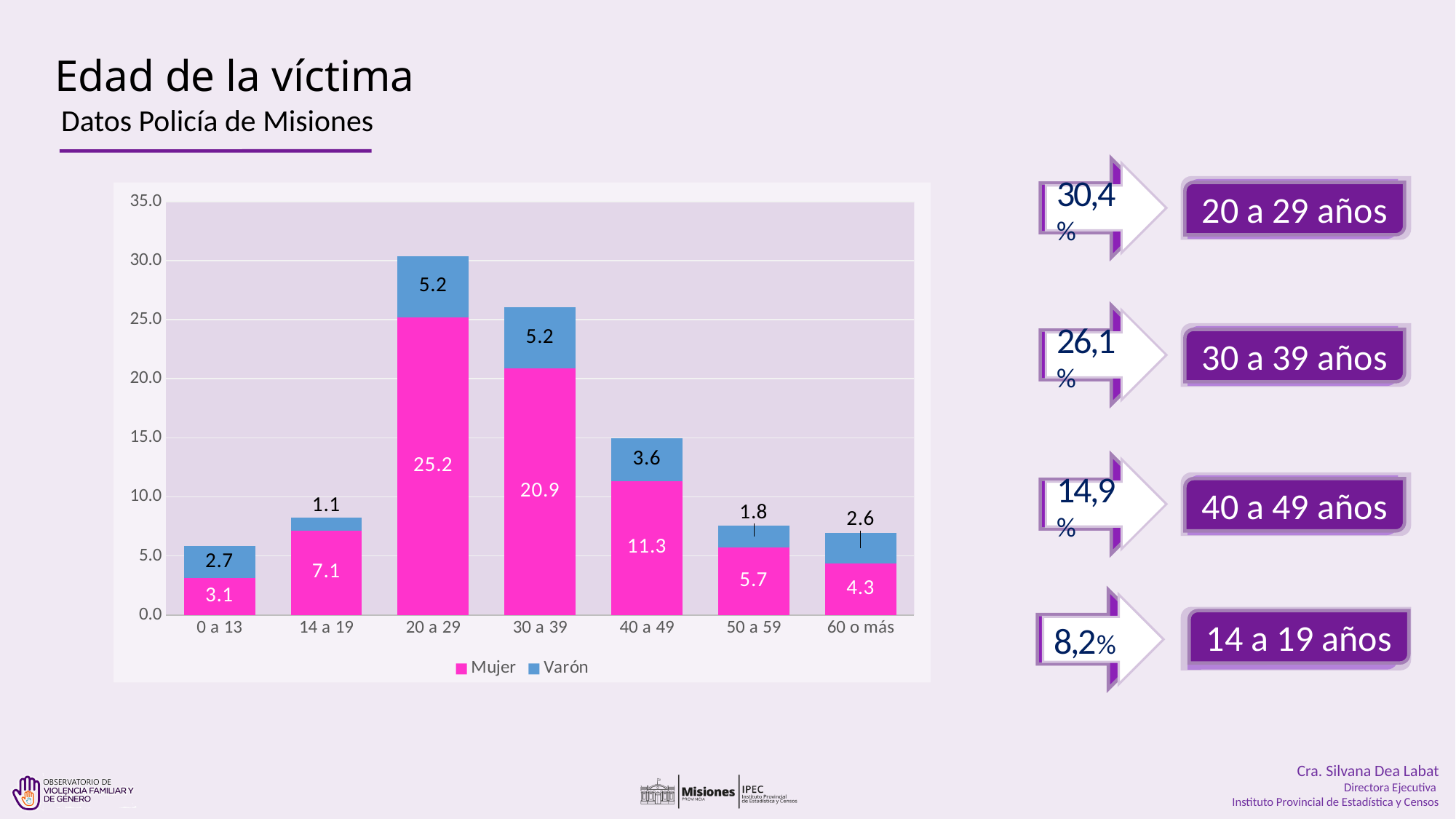
Which age group has the lowest Varón value? 14 a 19 Which is larger, the Varón value for 0 a 13 or the Varón value for 50 a 59? 0 a 13 How many series does the legend list? 2 How many age groups are shown on the x axis? 7 Which age group has the highest Mujer value? 20 a 29 What kind of chart is shown on the slide? Stacked bar chart What is the Varón value for the 40 a 49 age group? 3.6 What is the total stacked value for the 40 a 49 bar? 14.9 What is the difference between the Mujer values for 20 a 29 and 30 a 39? 4.3 What is the Mujer value for the 60 o más age group? 4.3 Is the total stacked value for the 30 a 39 bar greater or less than 25.0? greater What is the Mujer value for the 20 a 29 age group? 25.2